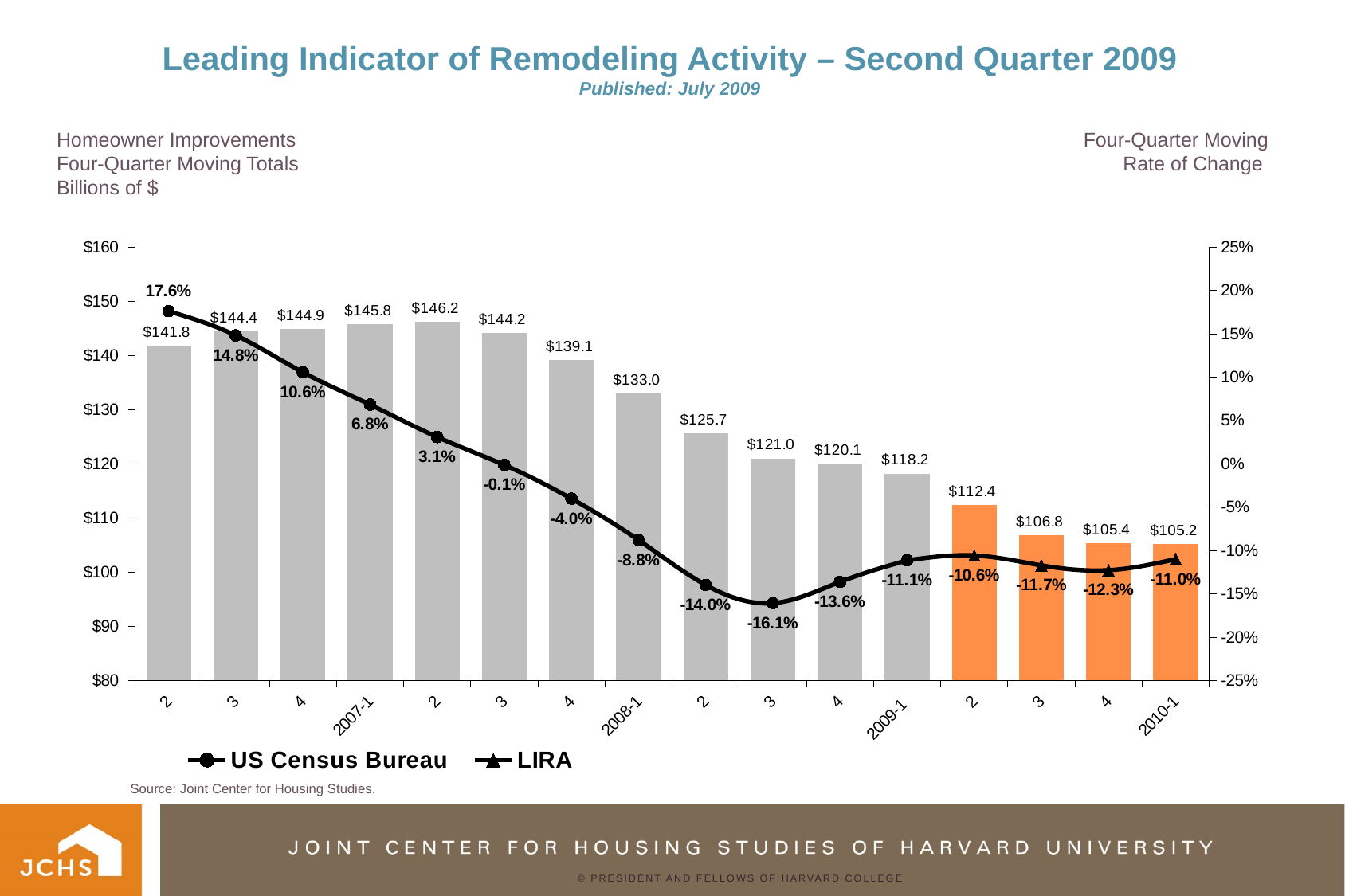
What is the four-quarter moving total for 2007-1? $145.8 What is the lowest four-quarter moving rate of change shown on the chart? -16.1% Which has the larger four-quarter moving total, 2007-1 or 2008-1? 2007-1 What is the four-quarter moving rate of change shown at 2009-1? -11.1% What is the highest four-quarter moving total shown on the chart? $146.2 What is the four-quarter moving total for 2009-1? $118.2 How many series does the legend list? 2 Do the four-quarter moving totals generally rise or fall from left to right across the chart? fall What is the highest four-quarter moving rate of change shown on the chart? 17.6% What is the four-quarter moving total projected for 2010-1? $105.2 How many bars are plotted on the chart? 16 What is the difference between the four-quarter moving totals for 2008-1 and 2009-1? $14.8